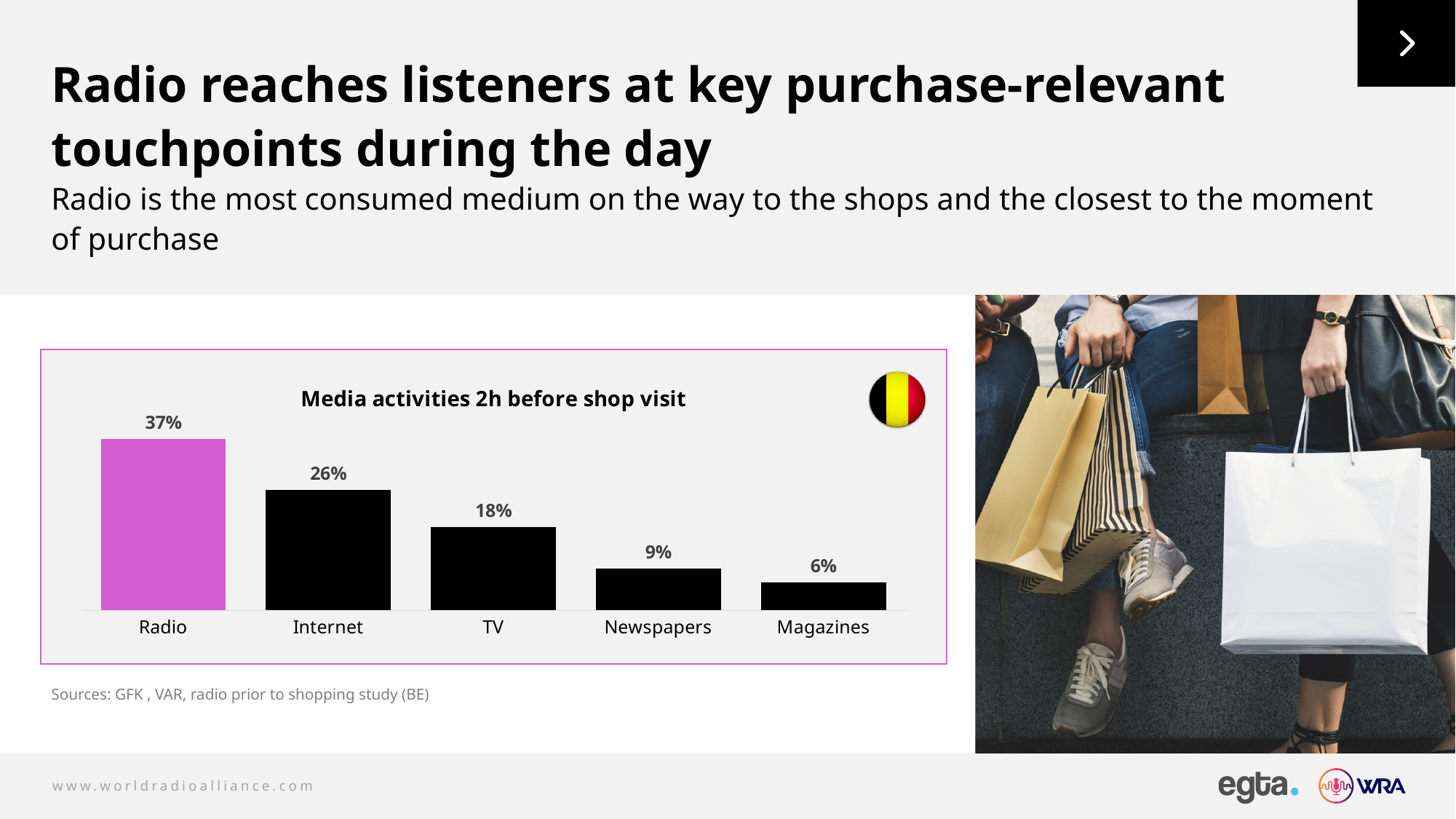
What is the value for Newspapers in the chart? 9% Which has a larger value, TV or Newspapers? TV How many categories are shown in the chart? 5 What is the difference between the values for Radio and Internet? 11% Which category has the highest value in the chart? Radio What is the value for Magazines in the chart? 6% What is the value for Internet in the chart? 26% What is the title of the chart? Media activities 2h before shop visit What is the value for TV in the chart? 18% What kind of chart is shown on the slide? Bar chart Which category has the lowest value in the chart? Magazines What is the value for Radio in the chart? 37%